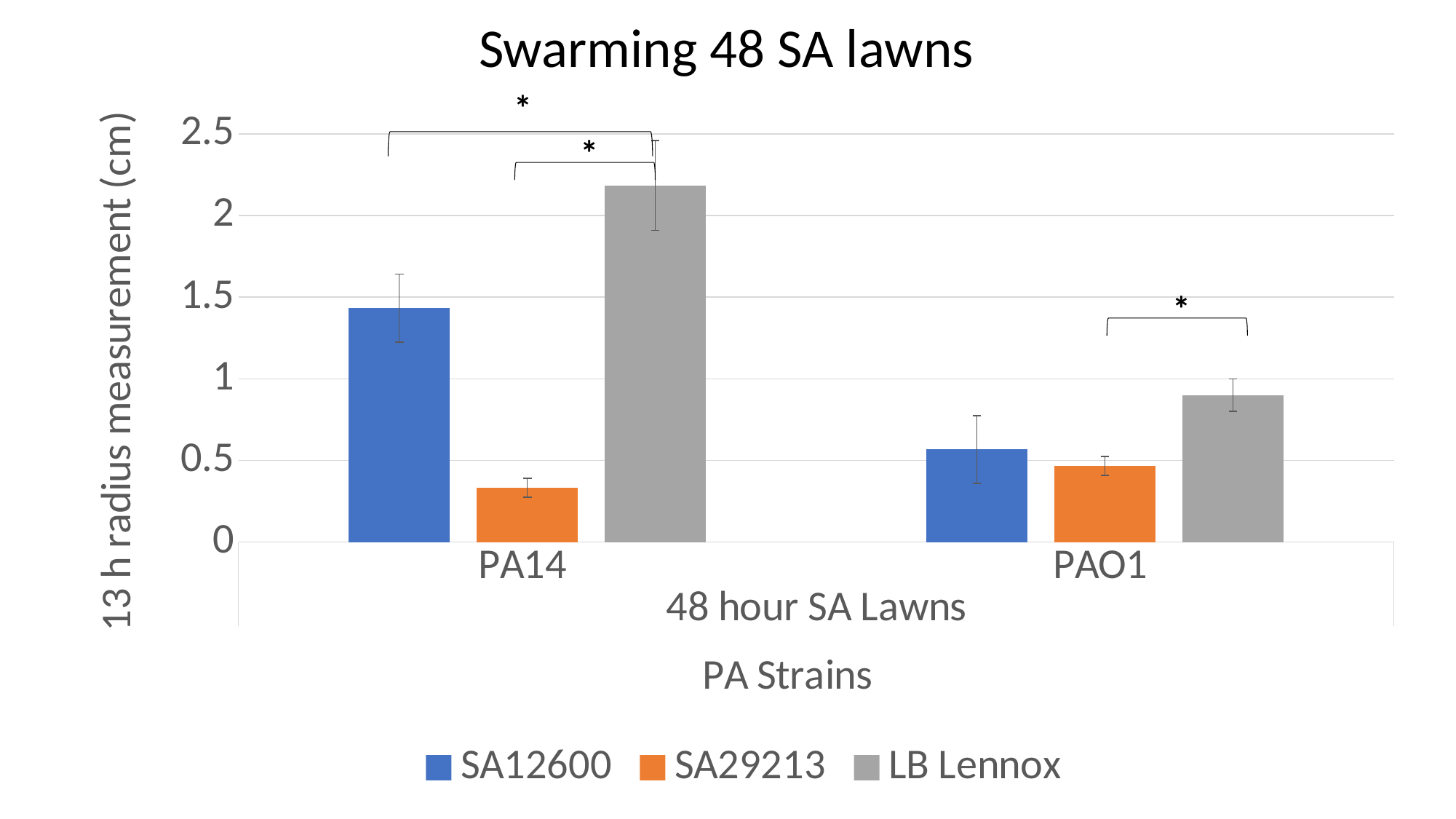
What type of chart is shown on the slide? bar chart Is the SA12600 value for PA14 greater or less than 1? greater Is the LB Lennox value for PA14 greater or less than 2? greater Which series has the highest bar for PA14? LB Lennox Is the LB Lennox value for PAO1 greater or less than 1? less Which is larger, the SA12600 value for PA14 or the SA12600 value for PAO1? PA14 Which series has the lowest bar for PA14? SA29213 How many PA strain categories are shown on the x axis? 2 Which series has the highest bar for PAO1? LB Lennox What is the title of the chart? Swarming 48 SA lawns How many series does the legend list? 3